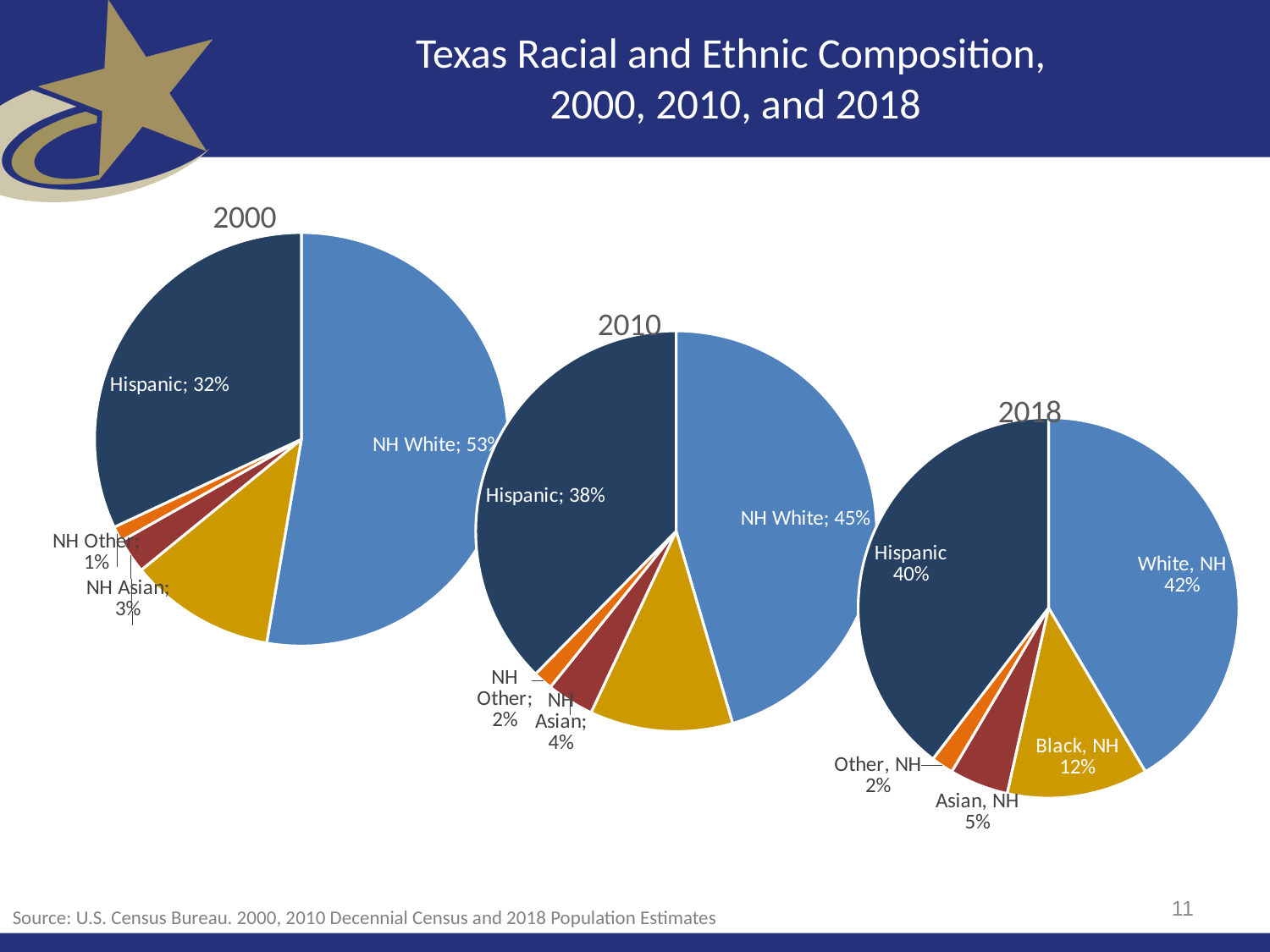
In the 2018 pie chart, which group has the largest share? White, NH In the 2000 pie chart, what share is NH White? 53% Is the NH Asian share larger in the 2000 pie chart or the 2010 pie chart? 2010 In the 2018 pie chart, what share is Asian, NH? 5% What is the title of the slide's charts? Texas Racial and Ethnic Composition, 2000, 2010, and 2018 In the 2010 pie chart, what is the difference between the NH White share and the Hispanic share? 7% What kind of charts are shown on the slide? Pie charts In the 2018 pie chart, what is the difference between the White, NH share and the Hispanic share? 2% In the 2018 pie chart, what share is Black, NH? 12% How many slices does the 2018 pie chart have? 5 In the 2000 pie chart, which labeled group has the smallest share? NH Other In the 2010 pie chart, what share is Hispanic? 38%